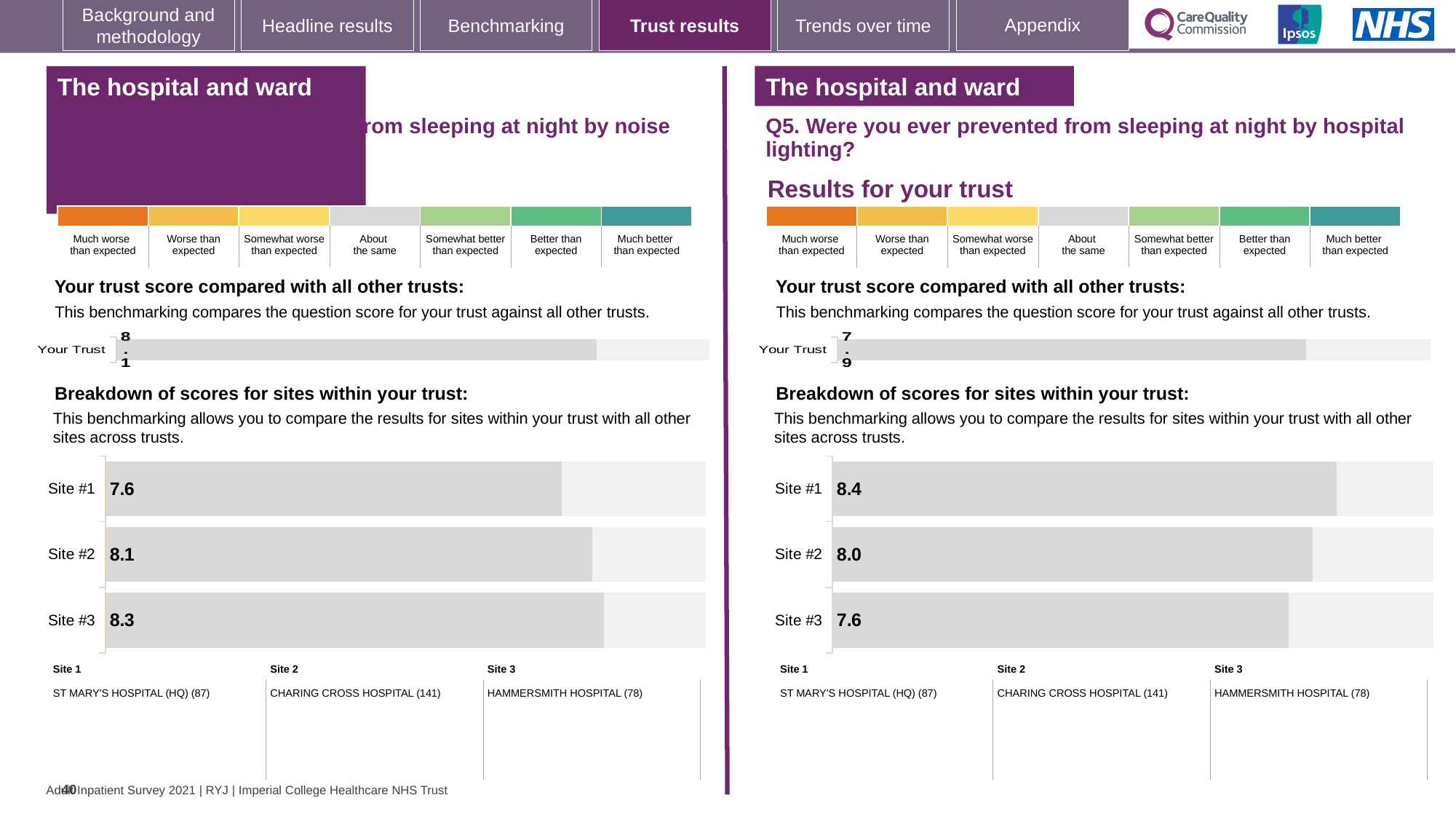
In the site breakdown chart on the left side of the slide (sleeping at night by noise), which site has the highest score? Site #3 In the 'Your trust score' chart on the left side of the slide (sleeping at night by noise), what is the score for Your Trust? 8.1 In the 'Your trust score' chart for Q5 (hospital lighting) on the right side of the slide, what is the score for Your Trust? 7.9 In the site breakdown chart on the left side of the slide (sleeping at night by noise), what is the score for Site #3? 8.3 In the site breakdown chart for Q5 (hospital lighting) on the right side of the slide, what is the score for Site #1? 8.4 In the site breakdown chart for Q5 (hospital lighting) on the right side of the slide, which site has the lowest score? Site #3 In the site breakdown chart on the left side of the slide (sleeping at night by noise), what is the score for Site #1? 7.6 How many sites are shown in the site breakdown chart for Q5 (hospital lighting) on the right side of the slide? 3 In the site breakdown chart on the left side of the slide (sleeping at night by noise), what is the difference between the scores for Site #3 and Site #1? 0.7 In the site breakdown chart on the left side of the slide (sleeping at night by noise), which site has the lowest score? Site #1 In the site breakdown chart for Q5 (hospital lighting) on the right side of the slide, is the score for Site #1 or Site #3 larger? Site #1 In the site breakdown chart for Q5 (hospital lighting) on the right side of the slide, what is the score for Site #2? 8.0